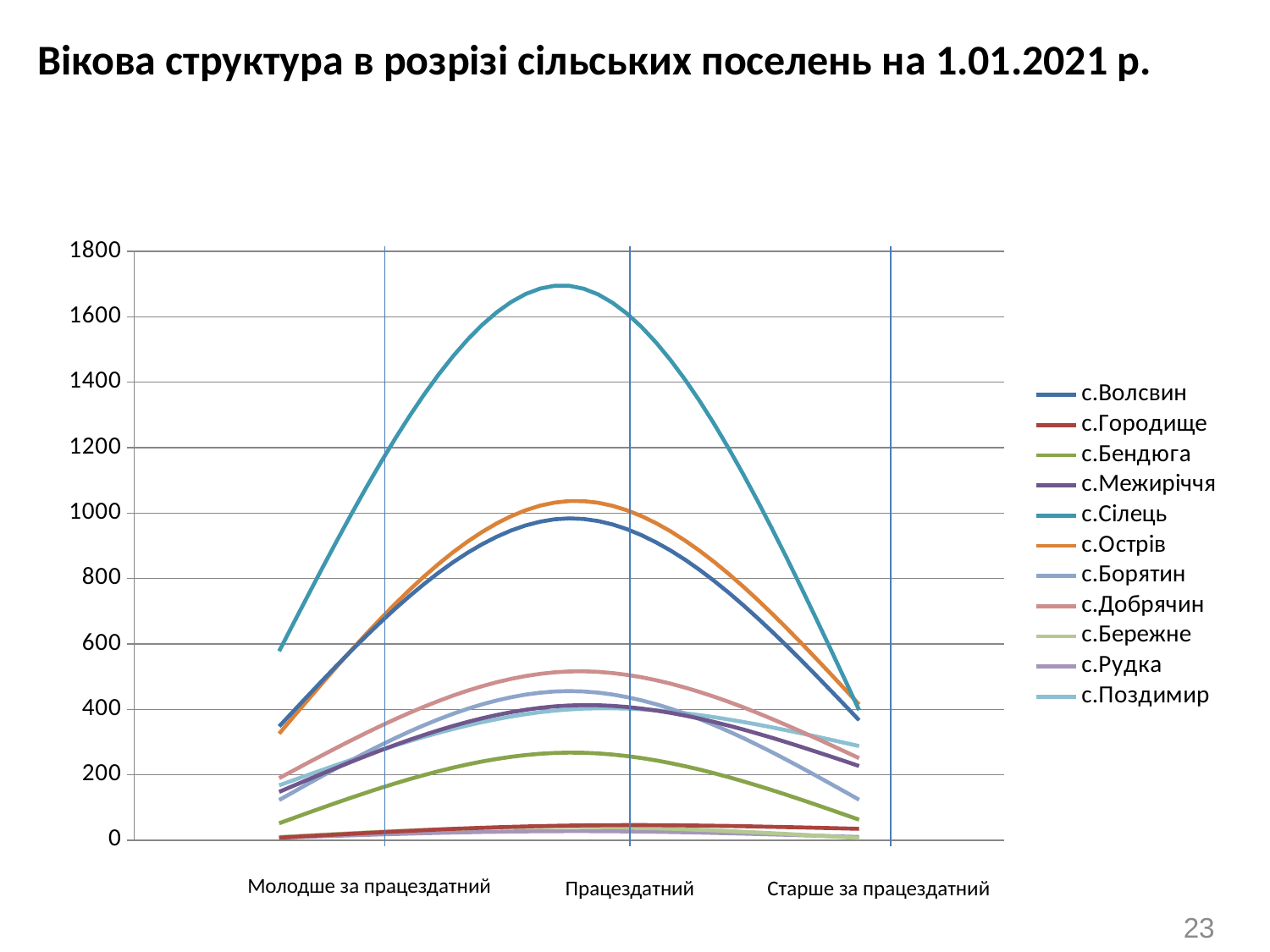
Is the value for с.Острів at Працездатний greater or less than 1000? greater How many categories are shown on the x axis? 3 What kind of chart is shown on the slide? line chart Is the value for с.Бендюга at Працездатний greater or less than 200? greater Is the value for с.Сілець at Працездатний greater or less than 1600? greater At Молодше за працездатний, which is larger: с.Сілець or с.Волсвин? с.Сілець How many series does the legend list? 11 Which series has the highest value for the category Працездатний? с.Сілець At Старше за працездатний, which is larger: с.Межиріччя or с.Борятин? с.Межиріччя What is the title of the slide? Вікова структура в розрізі сільських поселень на 1.01.2021 р.